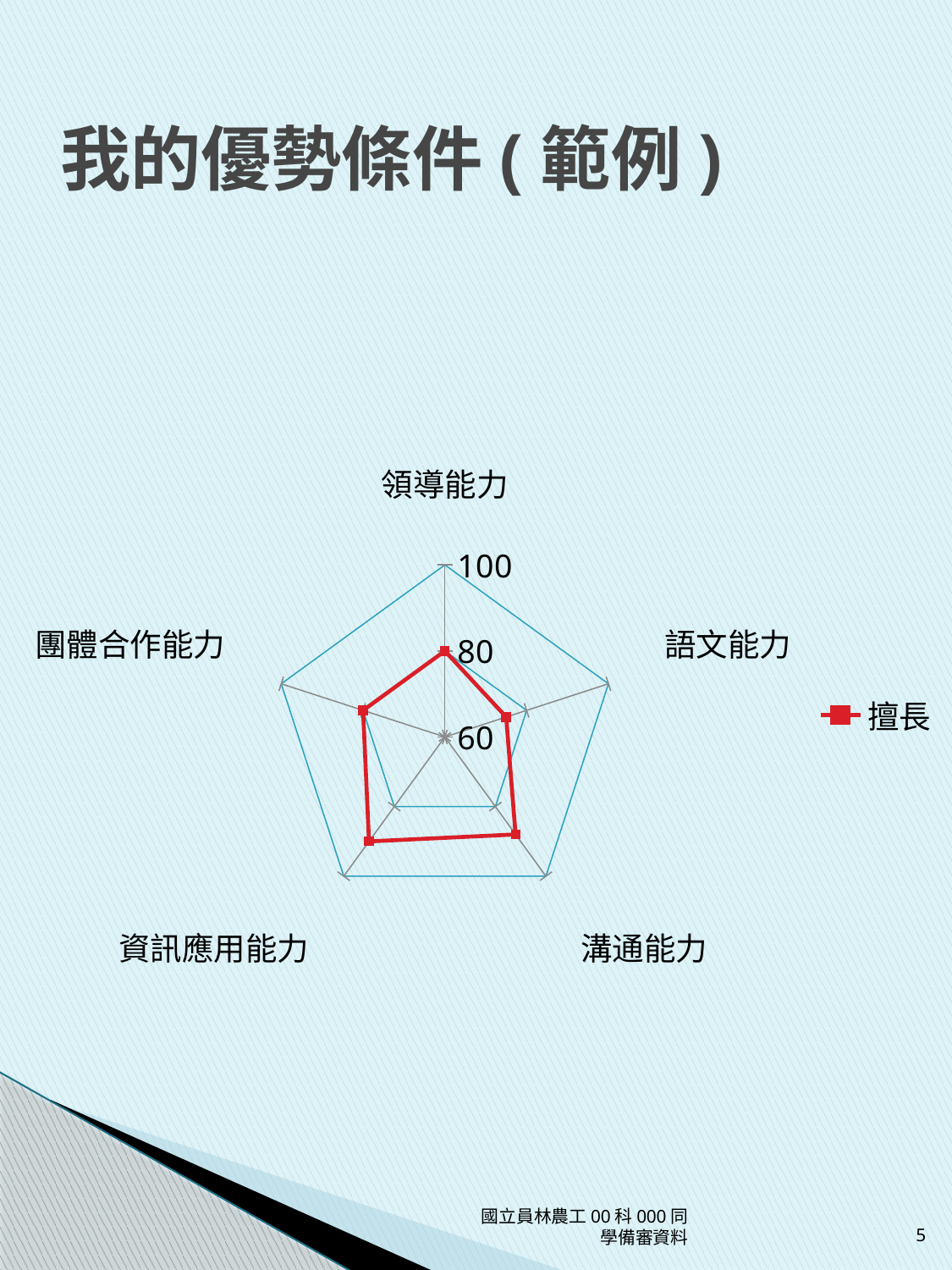
Is the value for 語文能力 greater or less than 80? less What is the name of the series shown in the legend? 擅長 Is the value for 溝通能力 greater or less than 100? less Is the value for 溝通能力 greater or less than 80? greater How many series does the legend list? 1 Which is larger, the value for 溝通能力 or the value for 語文能力? 溝通能力 Which category has the lowest value? 語文能力 What is the value for 領導能力? 80 What kind of chart is shown on the slide? radar chart What is the highest value shown on the chart's axis scale? 100 How many categories (axes) does the radar chart have? 5